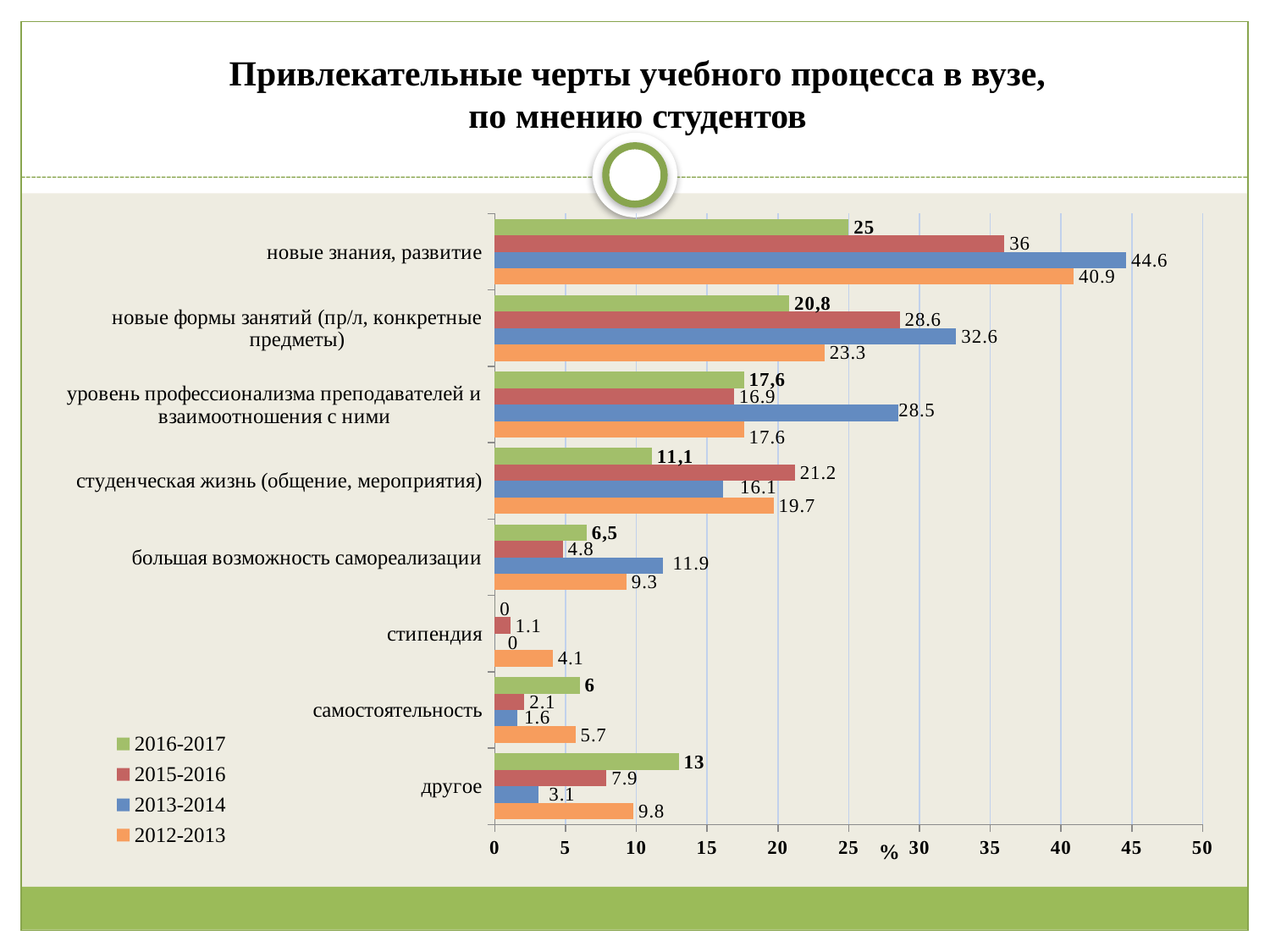
Which category has the highest value for the 2015-2016 series? новые знания, развитие What kind of chart is shown on the slide? bar chart What is the value for 2012-2013 in the category "стипендия"? 4.1 What is the value for 2016-2017 in the category "новые формы занятий (пр/л, конкретные предметы)"? 20,8 What is the value for 2013-2014 in the category "новые знания, развитие"? 44.6 Which category has the lowest value for the 2012-2013 series? стипендия Which colour represents the 2012-2013 series in the legend? orange Is the 2013-2014 value for "новые формы занятий (пр/л, конкретные предметы)" greater or less than 30? greater How many categories are shown on the chart? 8 How many series does the legend list? 4 What is the difference between the 2013-2014 and 2012-2013 values for "новые знания, развитие"? 3.7 Which is larger for "студенческая жизнь (общение, мероприятия)": the 2015-2016 value or the 2013-2014 value? 2015-2016